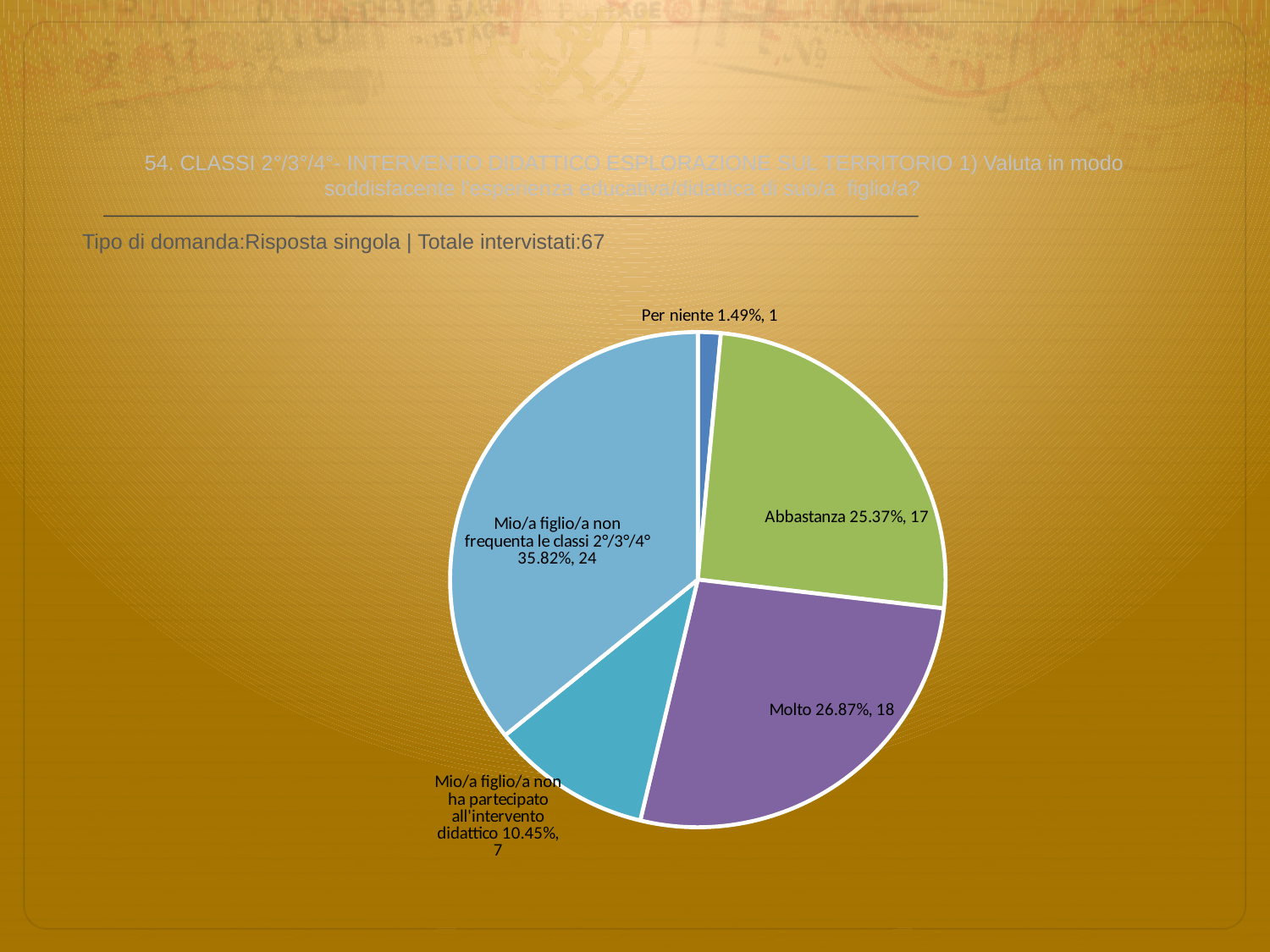
What is the difference in respondent count between "Molto" and "Abbastanza"? 1 Which category has the smallest slice of the pie? Per niente What percentage share does the "Molto" slice have? 26.87% What kind of chart is shown on the slide? pie chart What is the total number of respondents stated on the slide? 67 How many respondents answered "Mio/a figlio/a non frequenta le classi 2°/3°/4°"? 24 How many respondents answered "Abbastanza"? 17 How many slices does the pie chart have? 5 What percentage share does the "Mio/a figlio/a non ha partecipato all'intervento didattico" slice have? 10.45% Which category has the largest slice of the pie? Mio/a figlio/a non frequenta le classi 2°/3°/4° What percentage share does the "Per niente" slice have? 1.49% Which has more respondents, "Mio/a figlio/a non ha partecipato all'intervento didattico" or "Abbastanza"? Abbastanza